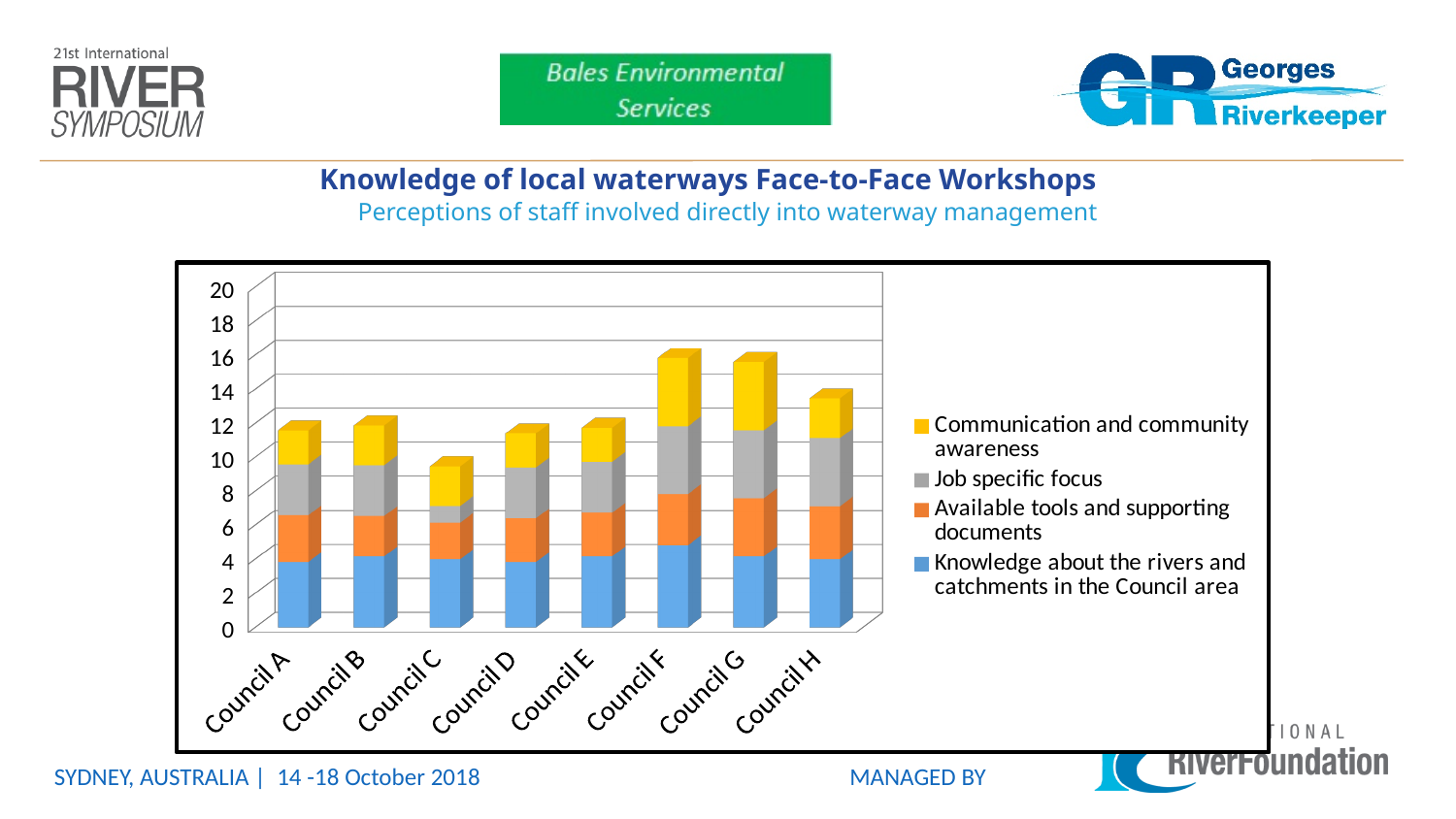
Which has the larger total, Council F or Council A? Council F Is the total for Council A greater or less than 14? less Which series is shown in yellow in the chart? Communication and community awareness Which series forms the bottom segment of each stacked bar? Knowledge about the rivers and catchments in the Council area Is the total for Council H greater or less than 12? greater Which has the larger total, Council C or Council D? Council D What kind of chart is shown on the slide? Stacked bar chart Which council has the lowest total stacked bar? Council C How many series does the chart's legend list? 4 How many councils are shown on the x axis of the chart? 8 Is the total for Council C greater or less than 12? less